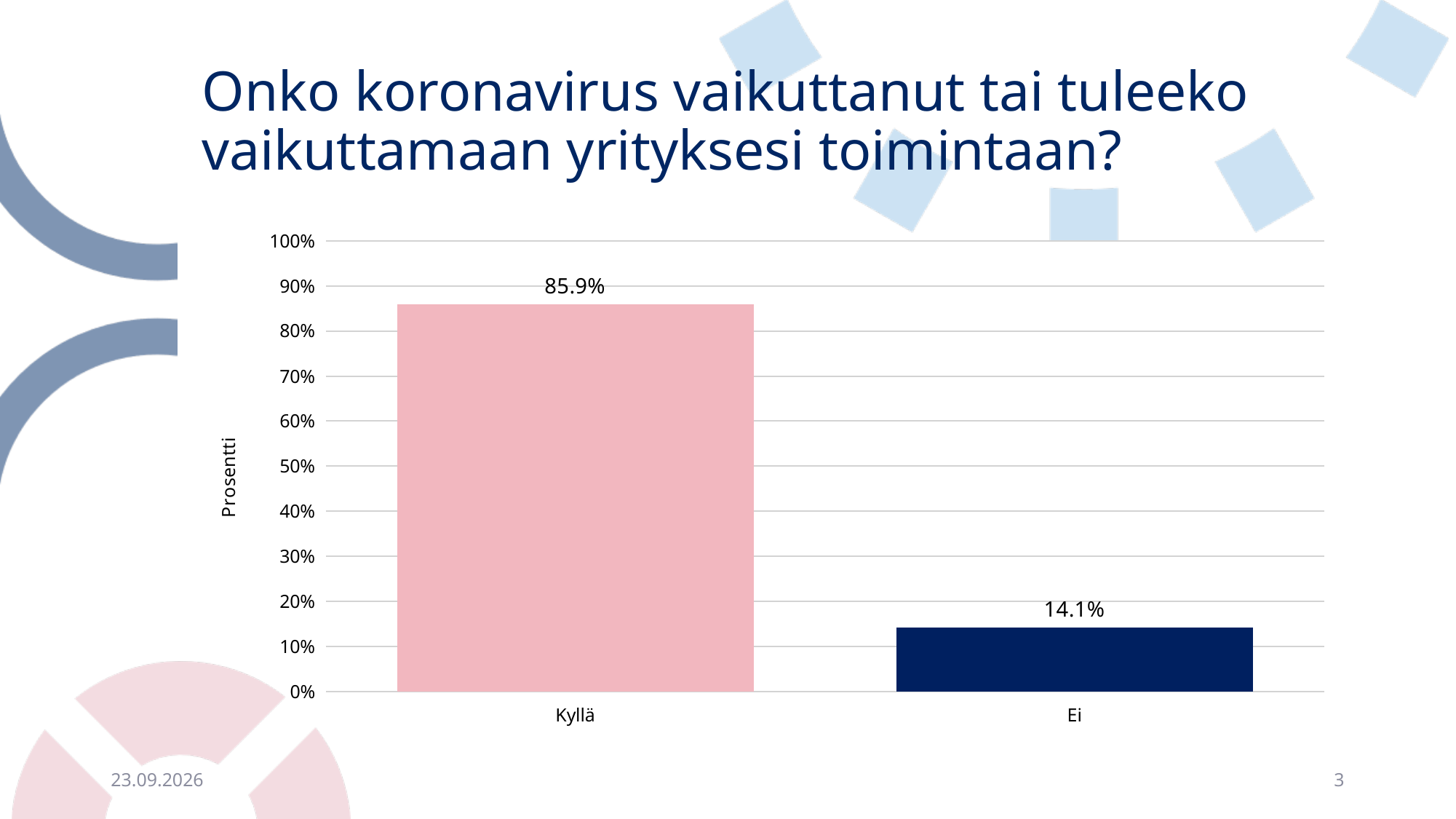
Which category has the highest value? Kyllä How many categories are shown on the x axis? 2 Is the value for Kyllä greater or less than 80%? greater What is the value for Kyllä? 85.9% What is the difference between the values for Kyllä and Ei? 71.8% Is the value for Ei greater or less than 20%? less What is the title of the slide above the chart? Onko koronavirus vaikuttanut tai tuleeko vaikuttamaan yrityksesi toimintaan? Which category has the lowest value? Ei What is the label of the vertical axis? Prosentti What kind of chart is shown on the slide? bar chart What is the value for Ei? 14.1% Which is larger, the value for Kyllä or the value for Ei? Kyllä